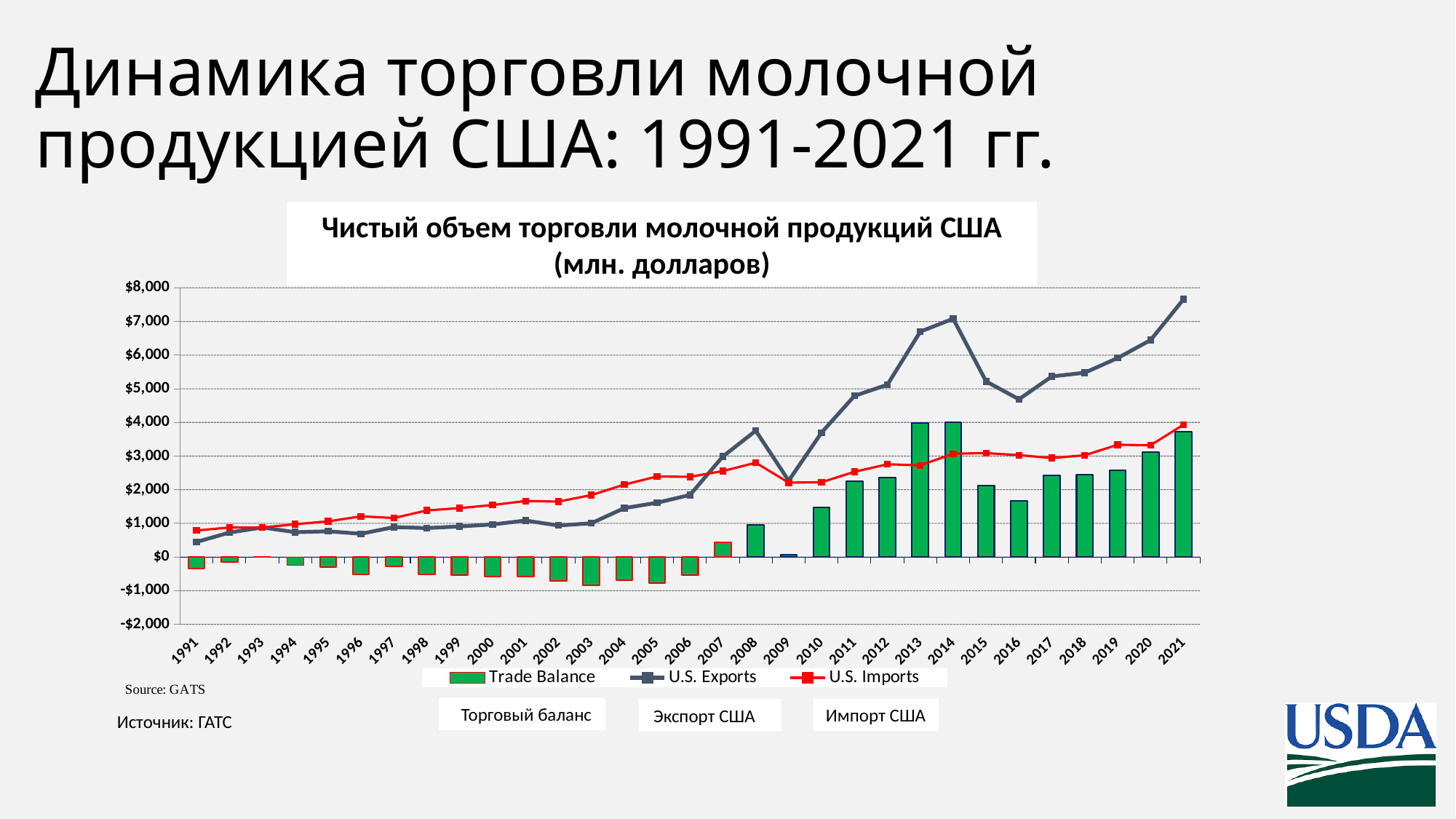
Is the value of U.S. Exports in 2016 greater or less than $5,000? less Which year has the larger Trade Balance bar: 2013 or 2015? 2013 In which year is the U.S. Imports line at its lowest? 1991 Is the value of U.S. Imports in 2021 greater or less than $3,000? greater What kind of chart is shown on the slide? A combined bar and line chart In which year is the U.S. Exports line at its highest? 2021 Does the U.S. Imports line generally rise or fall from 1991 to 2021? Rise How many years are shown along the x axis of the chart? 31 How many series does the chart legend list? 3 In 2021, which is larger: U.S. Exports or U.S. Imports? U.S. Exports Is the value of U.S. Exports in 2021 greater or less than $7,000? greater